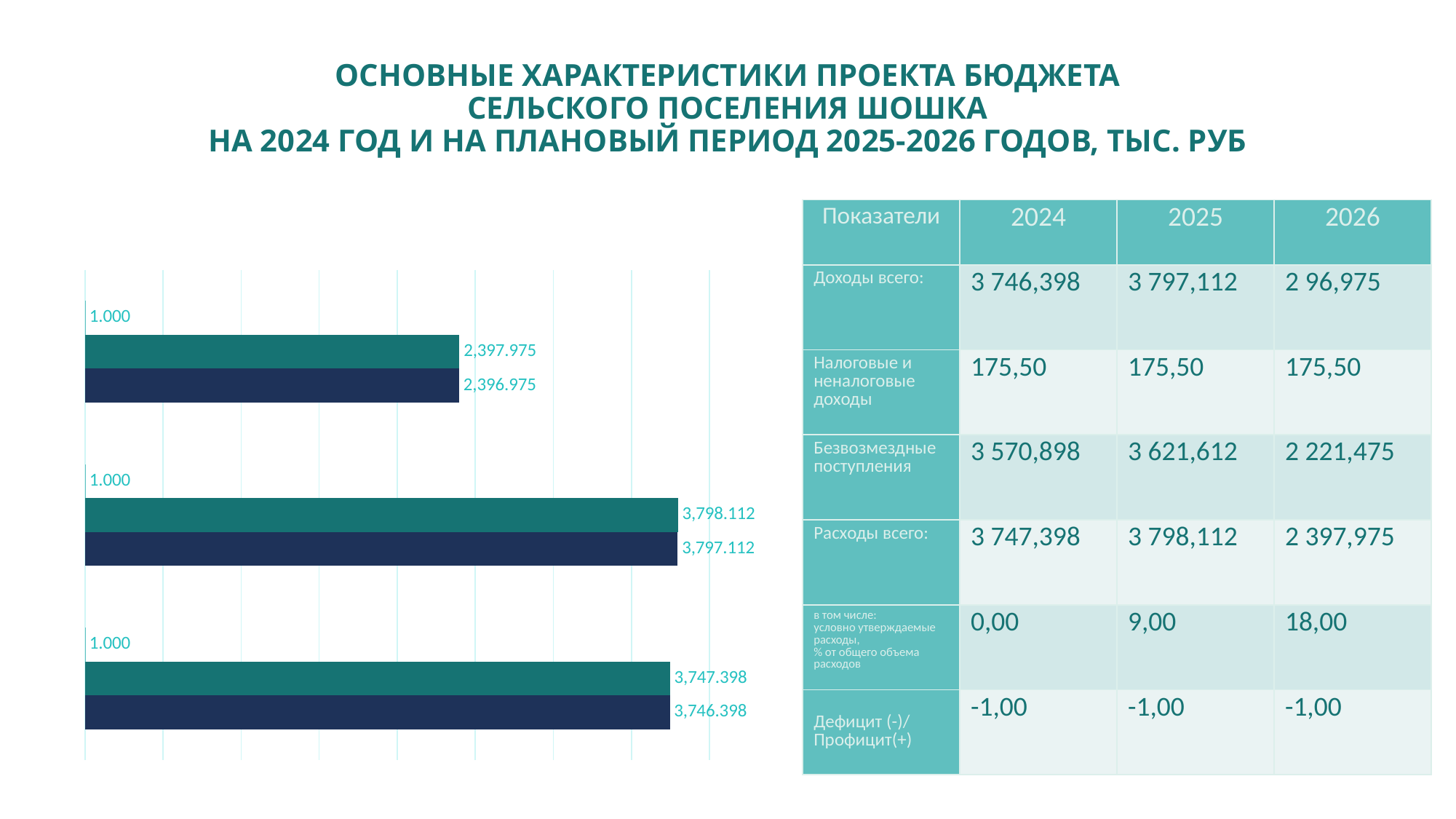
Which is larger: the teal bar in the bottom group or the teal bar in the top group? the teal bar in the bottom group In the middle group of bars, what value is labelled on the teal bar? 3,798.112 In the middle group of bars, what value is labelled on the dark navy bar? 3,797.112 In the top group of bars, what value is labelled on the dark navy bar? 2,396.975 In the bottom group of bars, what value is labelled on the teal bar? 3,747.398 Which group of bars (top, middle or bottom) has the longest teal bar? middle In the bottom group of bars, what value is labelled on the dark navy bar? 3,746.398 What kind of chart is shown on the left of the slide? bar chart In the top group of bars, what value is labelled on the teal bar? 2,397.975 In the middle group, what is the difference between the teal bar value and the dark navy bar value? 1.000 Which group of bars (top, middle or bottom) has the shortest dark navy bar? top How many groups of bars does the chart contain? 3